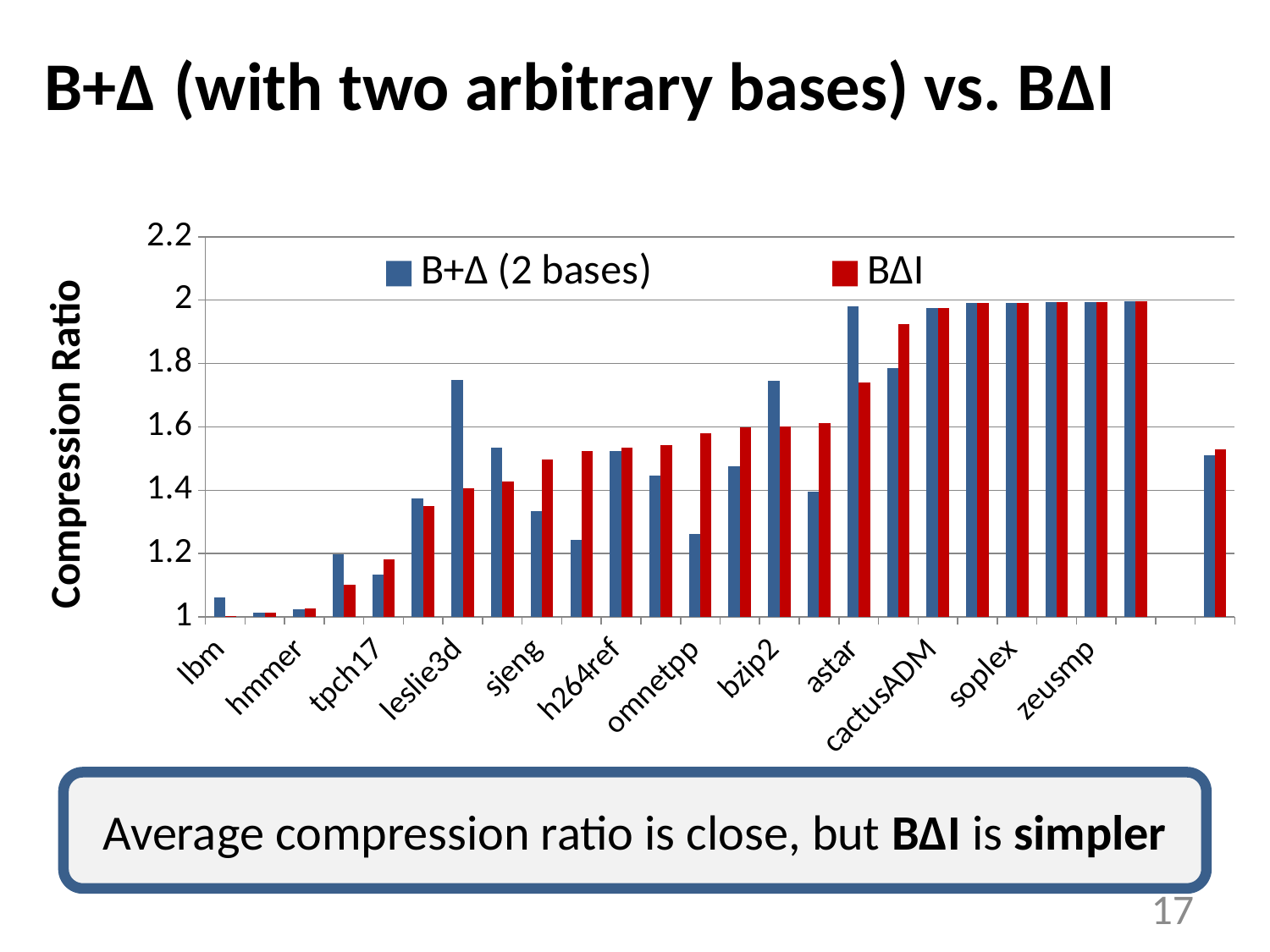
What is the label of the vertical axis of the chart? Compression Ratio Is the B+Δ (2 bases) value for leslie3d greater or less than 1.6? greater Is the BΔI value for zeusmp greater or less than 1.8? greater For omnetpp, which series has the larger compression ratio, B+Δ (2 bases) or BΔI? BΔI Is the BΔI value for sjeng greater or less than 1.4? greater What kind of chart is shown on the slide? bar chart How many series does the chart legend list? 2 For leslie3d, which series has the larger compression ratio, B+Δ (2 bases) or BΔI? B+Δ (2 bases) For astar, which series has the larger compression ratio, B+Δ (2 bases) or BΔI? B+Δ (2 bases) What are the two series named in the chart legend? B+Δ (2 bases) and BΔI